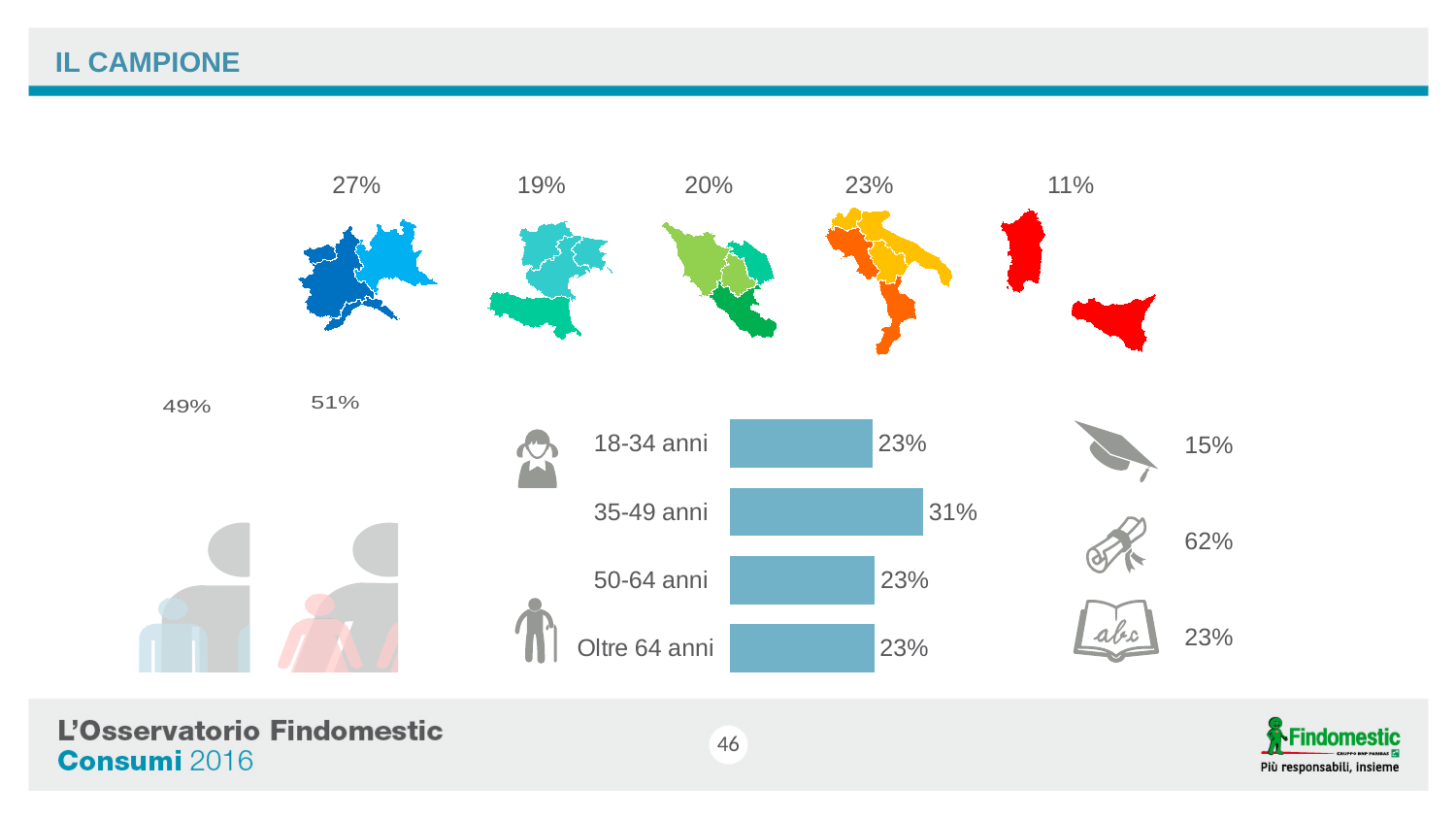
In the age-group bar chart, what is the value for Oltre 64 anni? 23% In the age-group bar chart, what is the value for 50-64 anni? 23% In the age-group bar chart, how many age groups share the value 23%? 3 In the age-group bar chart, which is larger: the value for 35-49 anni or the value for 50-64 anni? 35-49 anni In the age-group bar chart, what is the value for 18-34 anni? 23% In the age-group bar chart, what is the difference between the values for 35-49 anni and 18-34 anni? 8% What kind of chart is used to show the age groups on the slide? bar chart What colour are the bars in the age-group bar chart? blue How many age groups are shown in the age-group bar chart? 4 What is the title of the slide containing the age-group bar chart? IL CAMPIONE In the age-group bar chart, what is the value for 35-49 anni? 31% In the age-group bar chart, which age group has the highest value? 35-49 anni